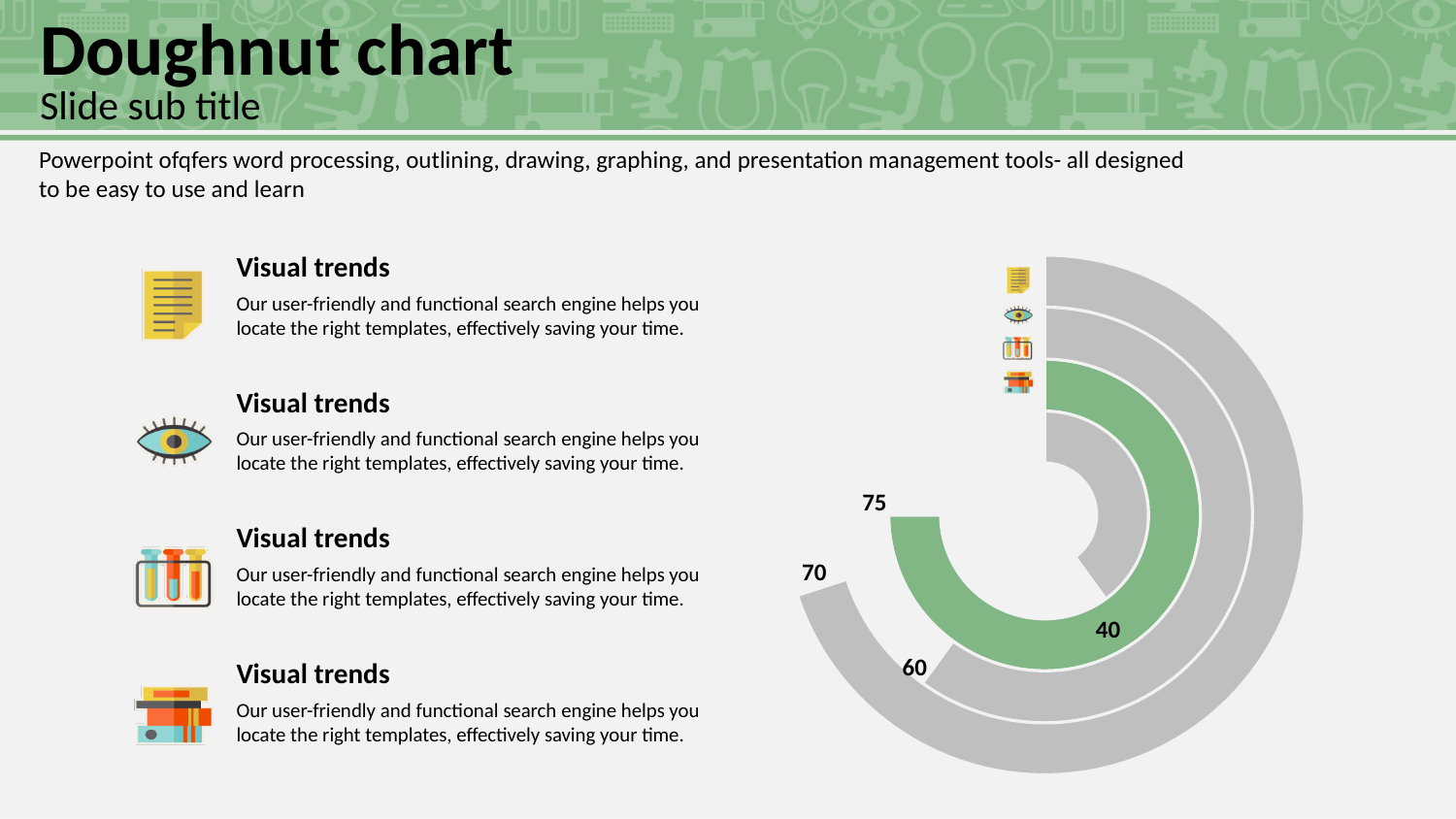
What is the title of the slide containing the chart? Doughnut chart What is the value labelled on the innermost (green) ring of the doughnut chart? 40 What is the difference between the highest and lowest values labelled on the doughnut chart? 35 How many rings (data points) does the doughnut chart have? 4 What is the lowest value labelled on the doughnut chart? 40 What is the difference between the values 70 and 60 shown on the doughnut chart? 10 Which is larger on the doughnut chart, the ring labelled 60 or the ring labelled 70? 70 What kind of chart is shown on the slide? Doughnut chart What colour is the innermost ring of the doughnut chart? Green What is the highest value labelled on the doughnut chart? 75